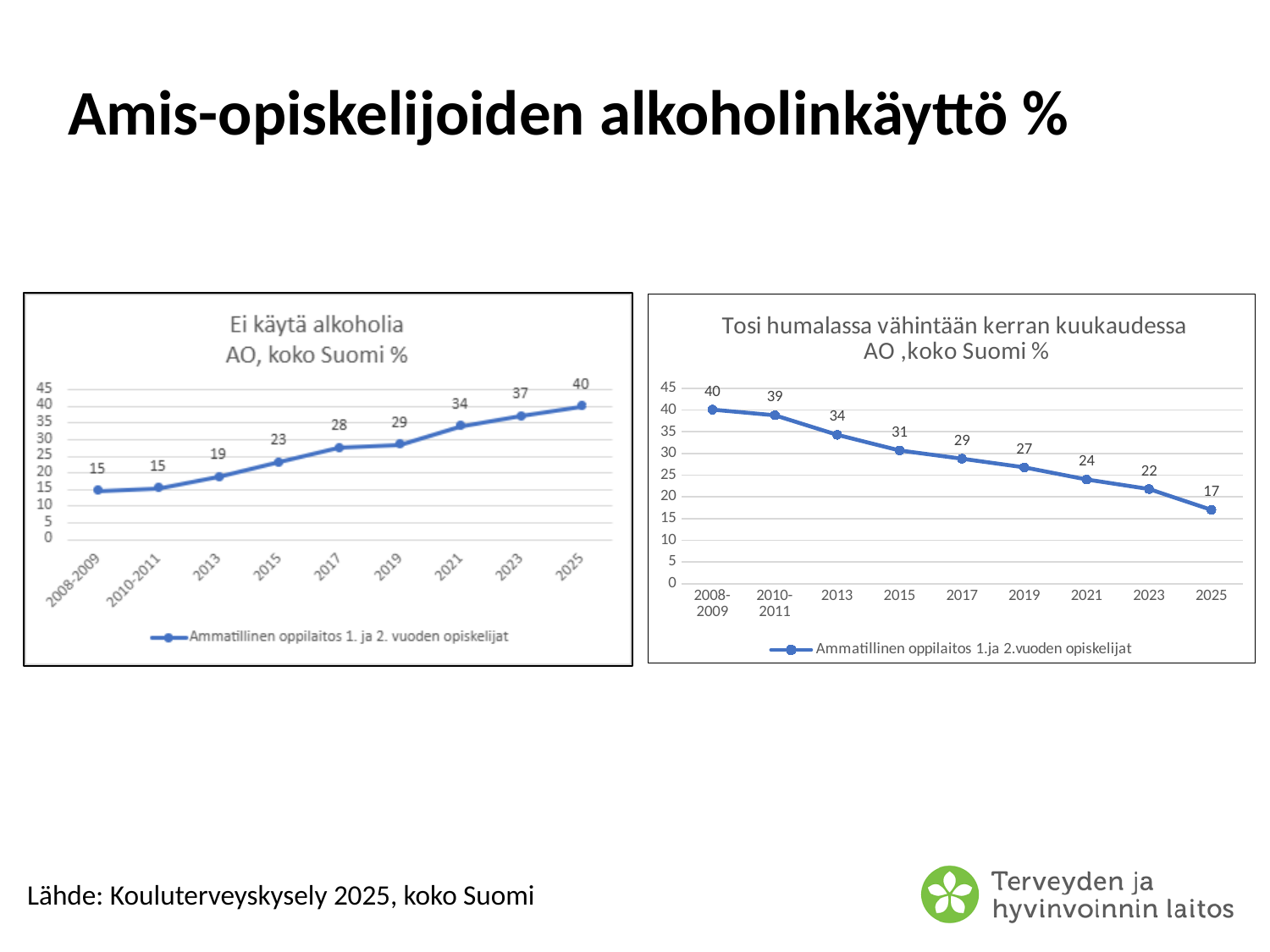
In the 'Tosi humalassa vähintään kerran kuukaudessa' chart, is the value for 2013 greater or less than 30? greater In the 'Tosi humalassa vähintään kerran kuukaudessa' chart, what is the difference between the values for 2008-2009 and 2025? 23 In the 'Ei käytä alkoholia' chart, what is the value for 2015? 23 In the 'Ei käytä alkoholia' chart, which year has the highest value? 2025 How many series does the legend of the 'Tosi humalassa vähintään kerran kuukaudessa' chart list? 1 In the 'Ei käytä alkoholia' chart, which is larger: the value for 2017 or the value for 2021? 2021 How many data points are plotted in the 'Ei käytä alkoholia' chart? 9 In the 'Tosi humalassa vähintään kerran kuukaudessa' chart, what is the value for 2019? 27 What kind of chart is the 'Ei käytä alkoholia' chart? Line chart In the 'Tosi humalassa vähintään kerran kuukaudessa' chart, do the values rise or fall from 2008-2009 to 2025? Fall In the 'Ei käytä alkoholia' chart, what is the difference between the values for 2025 and 2008-2009? 25 In the 'Tosi humalassa vähintään kerran kuukaudessa' chart, which year has the lowest value? 2025